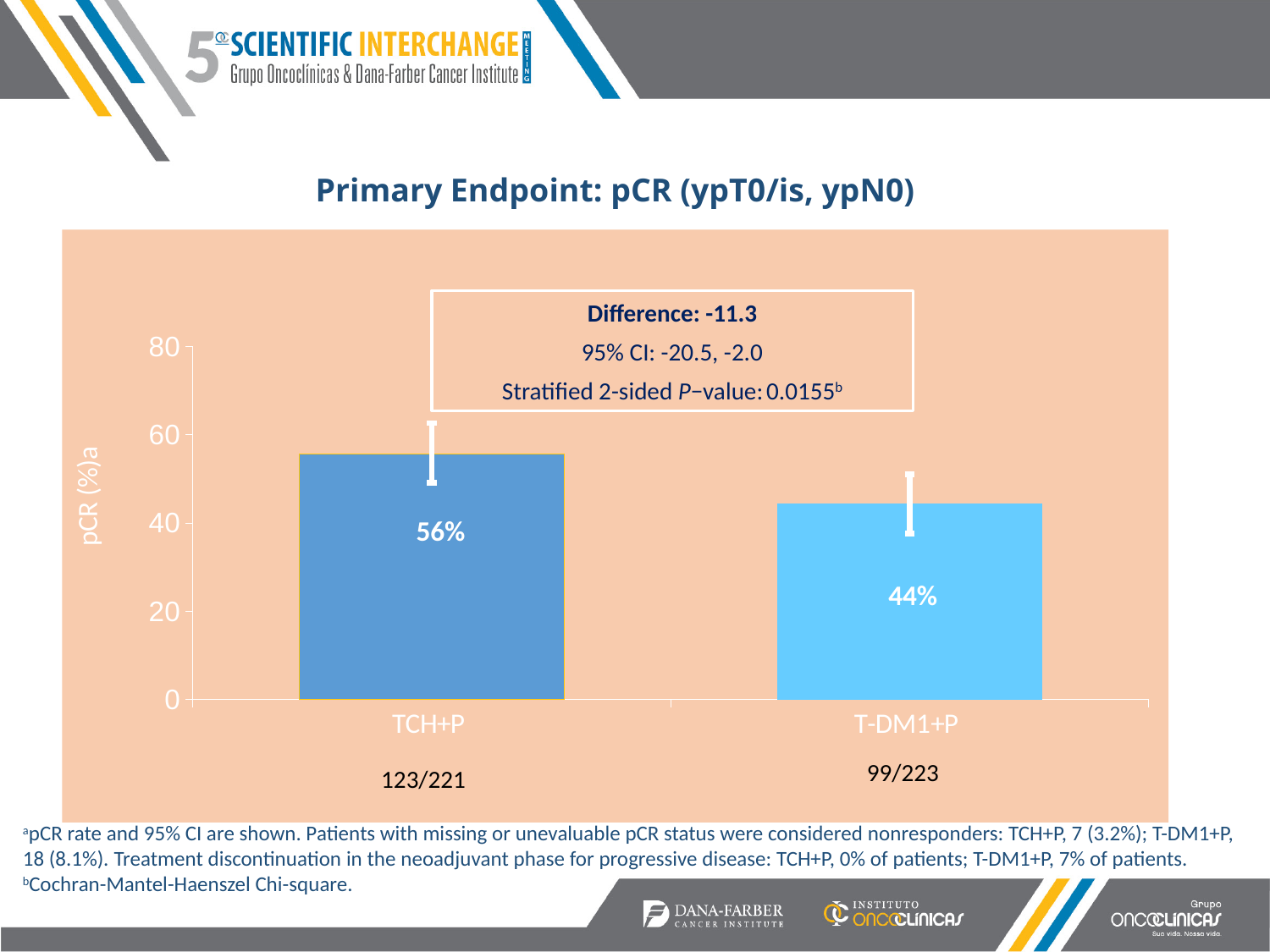
Which treatment arm has the lower pCR rate? T-DM1+P What is the difference reported in the box on the chart? -11.3 Is the pCR rate for T-DM1+P greater or less than 60? less What is the label of the y axis? pCR (%) What kind of chart is shown on the slide? Bar chart Is the pCR rate for TCH+P greater or less than 40? greater What is the pCR rate for T-DM1+P? 44% What is the title of the chart? Primary Endpoint: pCR (ypT0/is, ypN0) Which treatment arm has the higher pCR rate? TCH+P What is the pCR rate for TCH+P? 56% How many treatment arms are shown on the chart? 2